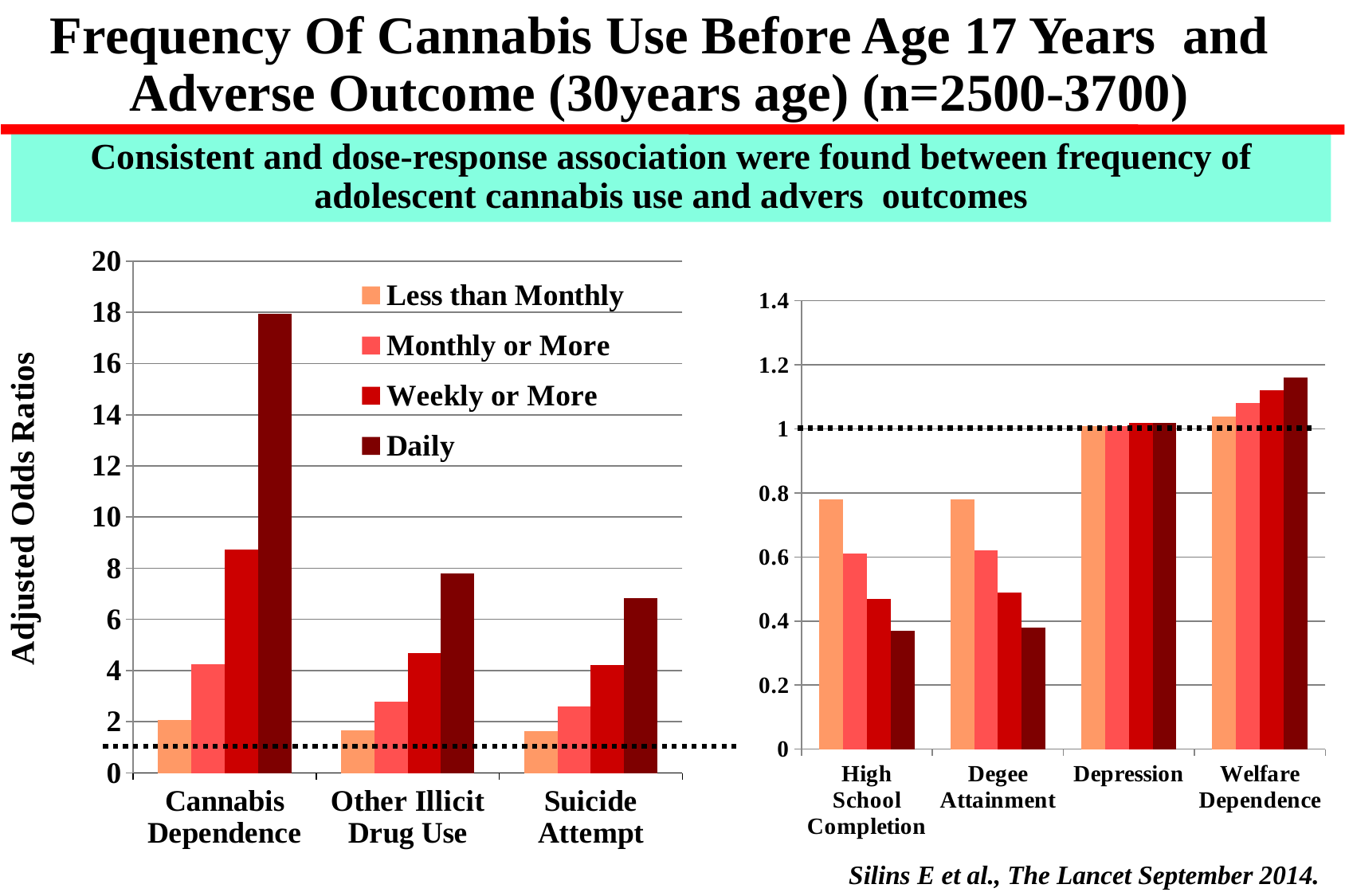
How many outcome categories are shown on the x axis of the left chart? 3 In the right chart, is the Daily value for High School Completion greater or less than 0.4? less What kind of chart is the left chart on the slide? bar chart In the left chart, for Suicide Attempt, which is larger: the Daily value or the Weekly or More value? Daily How many series does the legend of the left chart list? 4 In the left chart, is the Weekly or More value for Cannabis Dependence greater or less than 8? greater In the left chart, is the Daily value for Cannabis Dependence greater or less than 16? greater What is the y-axis label of the left chart? Adjusted Odds Ratios How many outcome categories are shown on the x axis of the right chart? 4 In the left chart, which outcome has the highest bar for the Daily series? Cannabis Dependence